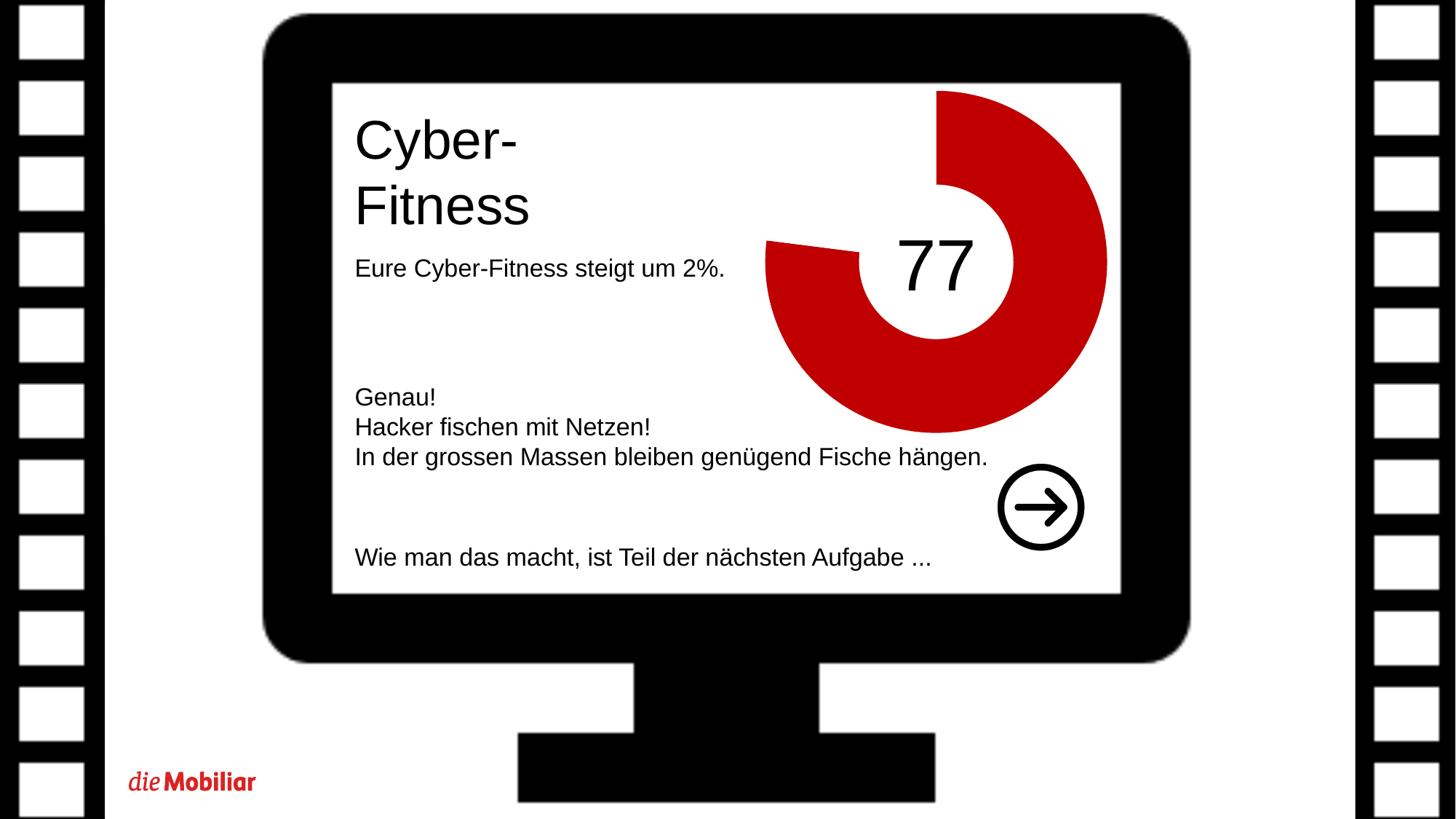
What is the title shown next to the doughnut chart? Cyber-Fitness What kind of chart is shown on the slide? doughnut chart What number is displayed in the centre of the doughnut chart? 77 Does the red arc of the doughnut chart cover more or less than half of the ring? more How many filled segments does the doughnut chart show? 1 What colour is the filled arc of the doughnut chart? red